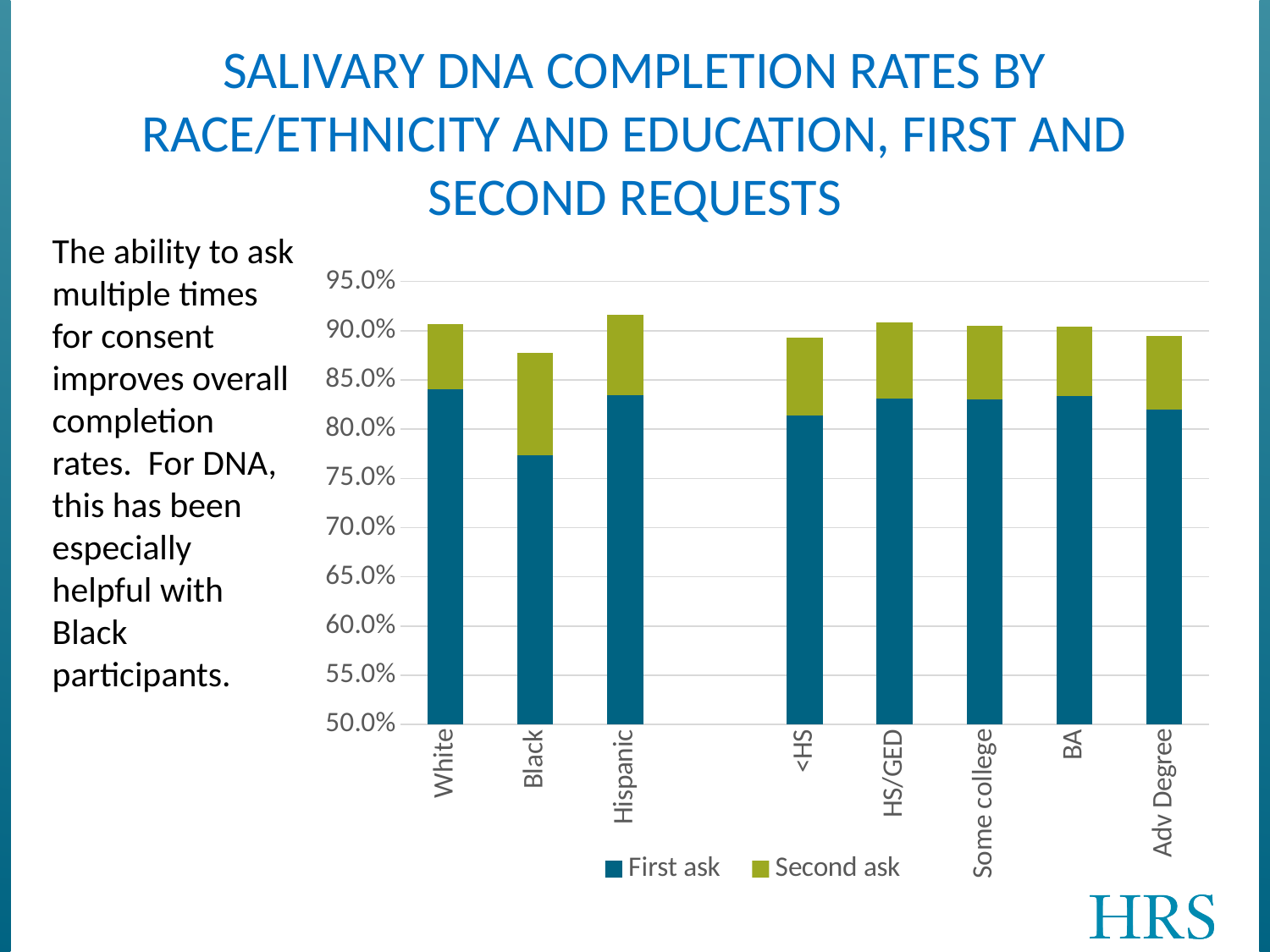
Which category has the lowest First ask value? Black How many categories are shown along the x axis? 8 Is the First ask value for White greater or less than 80.0%? greater Which category has the larger Second ask segment, White or Black? Black Is the First ask value for Black greater or less than 80.0%? less Which is larger, the First ask value for White or the First ask value for Black? White How many series does the legend list? 2 Is the total stacked bar for Black greater or less than 90.0%? less What kind of chart is shown on the slide? Stacked bar chart Which category has the lowest total (First ask plus Second ask) bar? Black What are the two series named in the legend? First ask and Second ask